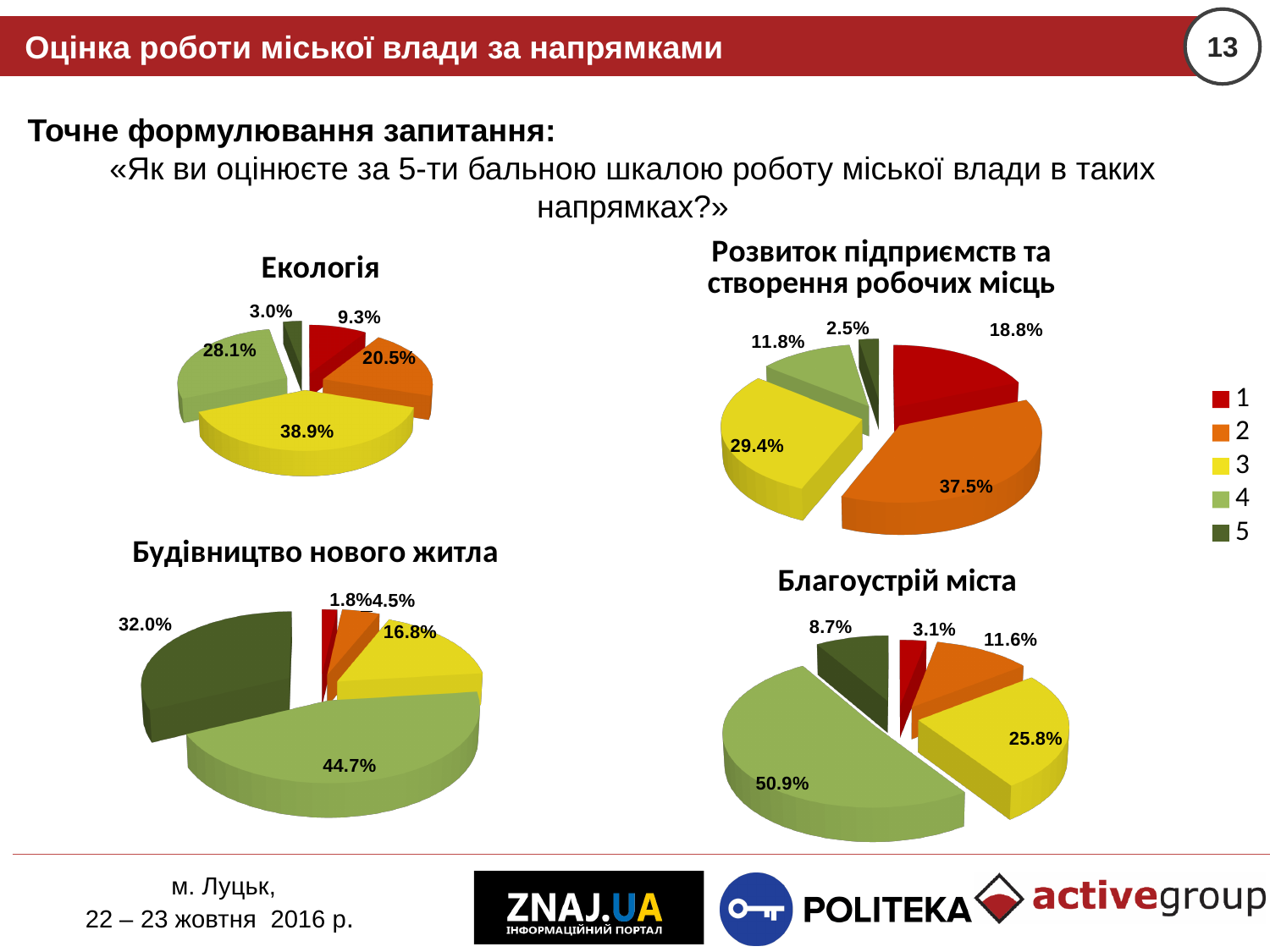
In the 'Екологія' chart, which rating has the smallest share? 5 In the 'Розвиток підприємств та створення робочих місць' chart, which rating has the largest share? 2 In the 'Розвиток підприємств та створення робочих місць' chart, what share is shown for rating 2? 37.5% How many entries does the legend on the slide list? 5 In the 'Благоустрій міста' chart, what is the difference between the shares for rating 3 and rating 2? 14.2% In the 'Будівництво нового житла' chart, what share is shown for rating 5? 32.0% In the 'Благоустрій міста' chart, which is larger, the share for rating 2 or the share for rating 5? rating 2 In the 'Благоустрій міста' chart, what share is shown for rating 4? 50.9% In the 'Екологія' chart, what share is shown for rating 3? 38.9% In the 'Будівництво нового житла' chart, what is the difference between the shares for rating 4 and rating 5? 12.7% What kind of chart is 'Будівництво нового житла'? pie chart How many slices does the 'Екологія' chart have? 5